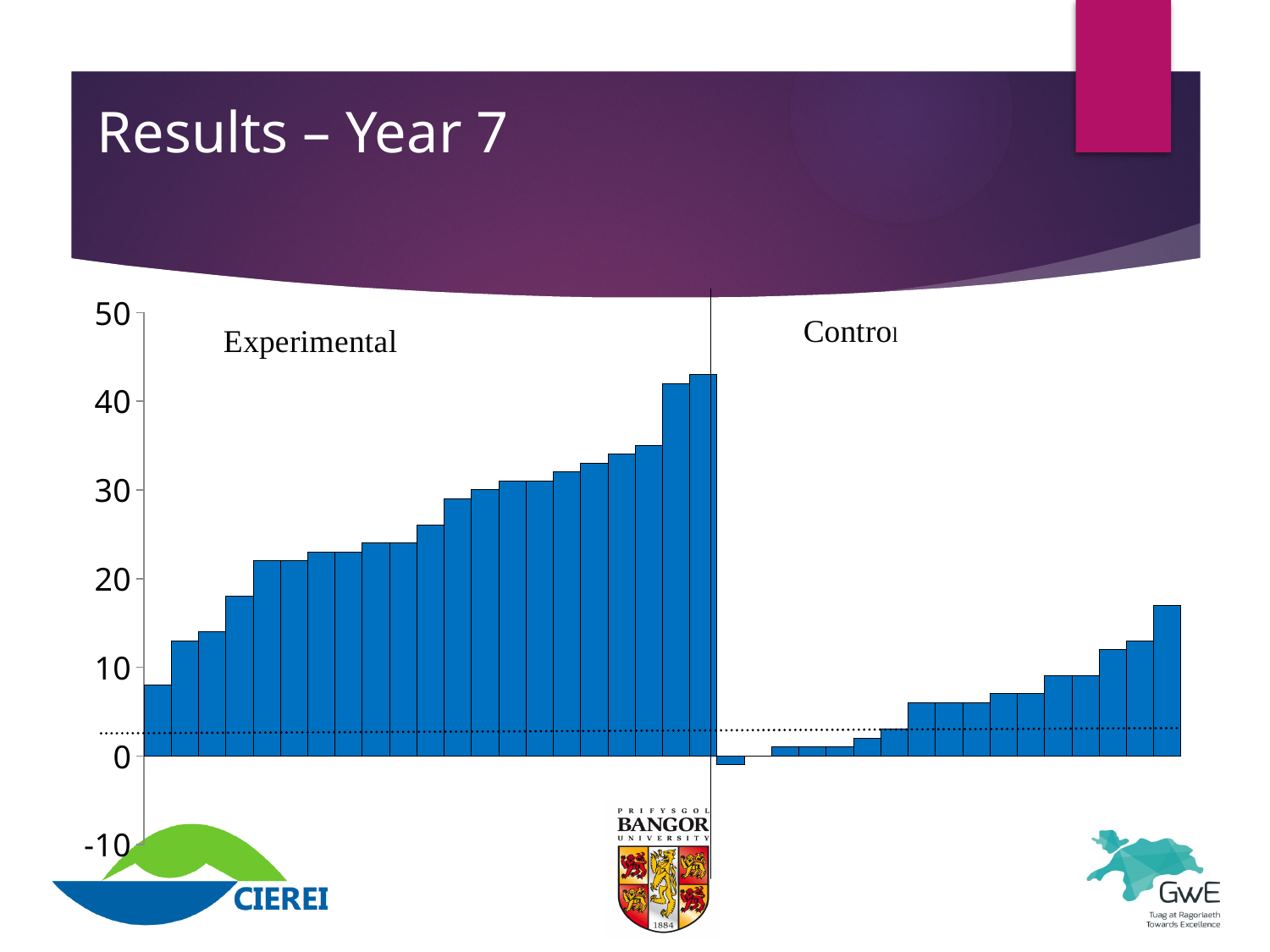
Which group has the bar with the lowest value on the chart? Control How many bars in the Control group fall below 0? 1 What is the highest value shown on the vertical axis of the chart? 50 Is the tallest bar in the Control group greater or less than 10? greater Is the tallest bar in the Control group greater or less than 20? less Is the tallest bar in the Experimental group greater or less than 40? greater Do the bars in the Experimental group rise or fall from left to right? rise What kind of chart is shown on the slide? bar chart Do the bars in the Control group rise or fall from left to right? rise What are the two groups of bars labelled on the chart? Experimental and Control Which group, Experimental or Control, contains the tallest bar on the chart? Experimental